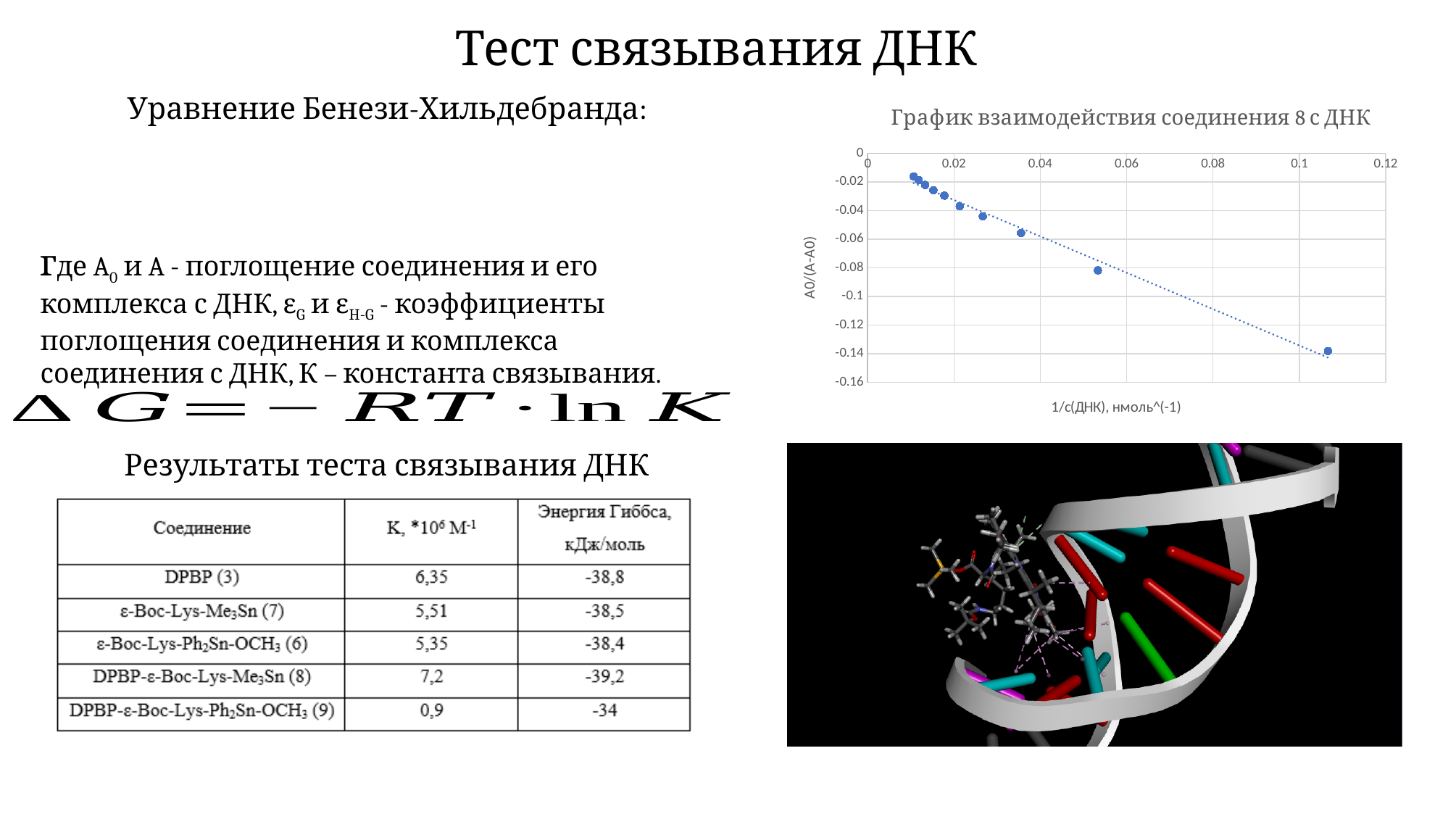
Is the y value of the rightmost point on the chart greater or less than -0.12? less Which point has the lowest y value on the chart: the leftmost point or the rightmost point? The rightmost point Is the y value of the point near x = 0.035 greater or less than -0.04? less Do the plotted values rise or fall as the x value increases along the chart? Fall Is the y value of the leftmost point on the chart greater or less than -0.04? greater What kind of chart is shown on the slide? Scatter chart What is the title of the chart on the slide? График взаимодействия соединения 8 с ДНК Which has the larger y value: the point near x = 0.02 or the point near x = 0.1? The point near x = 0.02 What is the largest tick value shown on the x axis of the chart? 0.12 Which point has the highest y value on the chart: the leftmost point or the rightmost point? The leftmost point What is the label of the vertical axis of the chart? A0/(A-A0)